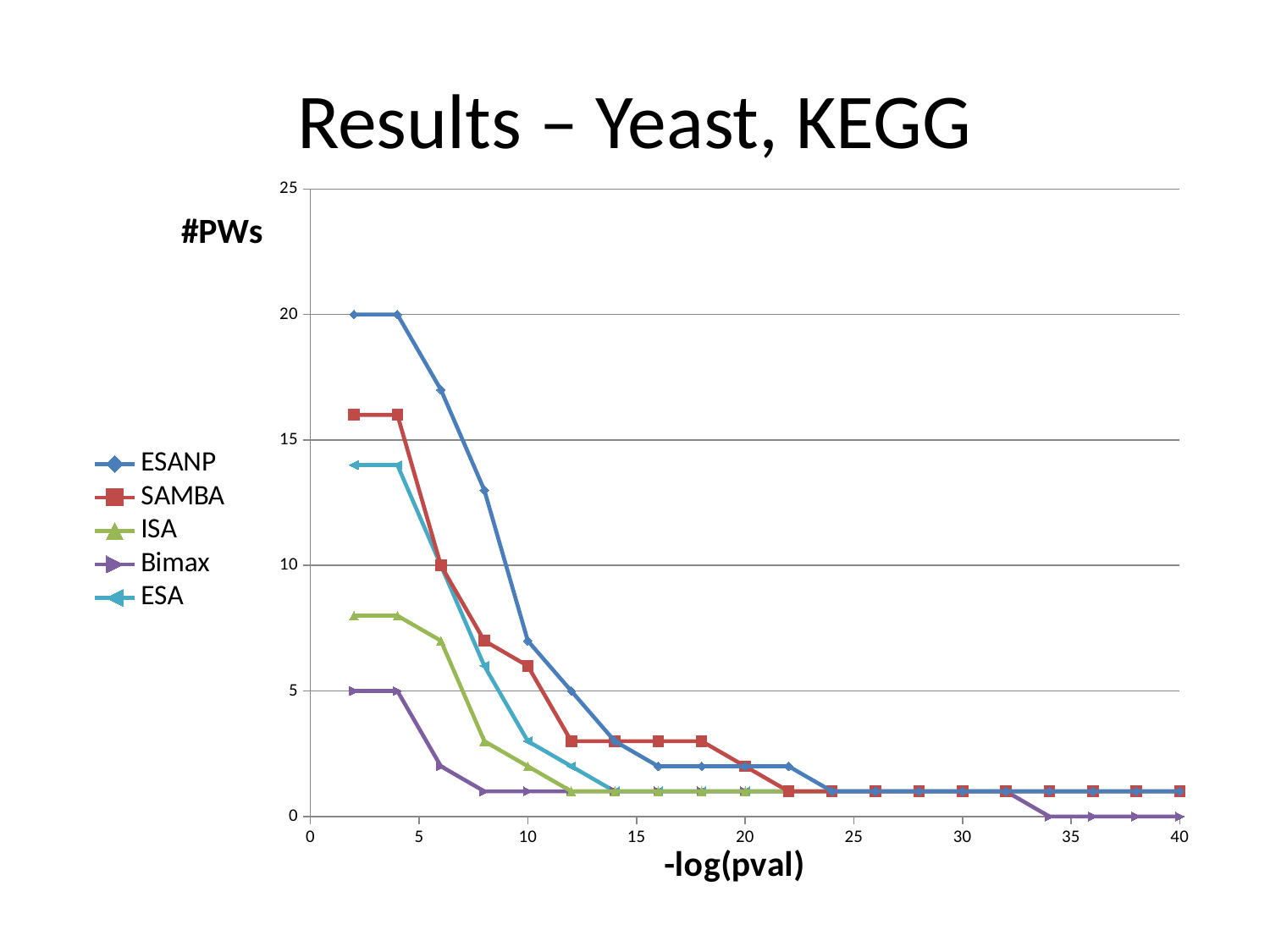
What is the value of SAMBA at -log(pval) = 6? 10 What is the value of Bimax at -log(pval) = 40? 0 Is the value for ESA at -log(pval) = 2 greater or less than 10? greater What is the value of ESANP at -log(pval) = 2? 20 Which series has the lowest value at -log(pval) = 2? Bimax What is the value of Bimax at -log(pval) = 2? 5 What is the label on the x axis of the chart? -log(pval) Do the values for ESANP rise or fall as -log(pval) increases? fall What kind of chart is shown on the slide? line chart How many series does the legend list? 5 Is the value for ISA at -log(pval) = 4 greater or less than 10? less Which series has the highest value at -log(pval) = 2? ESANP